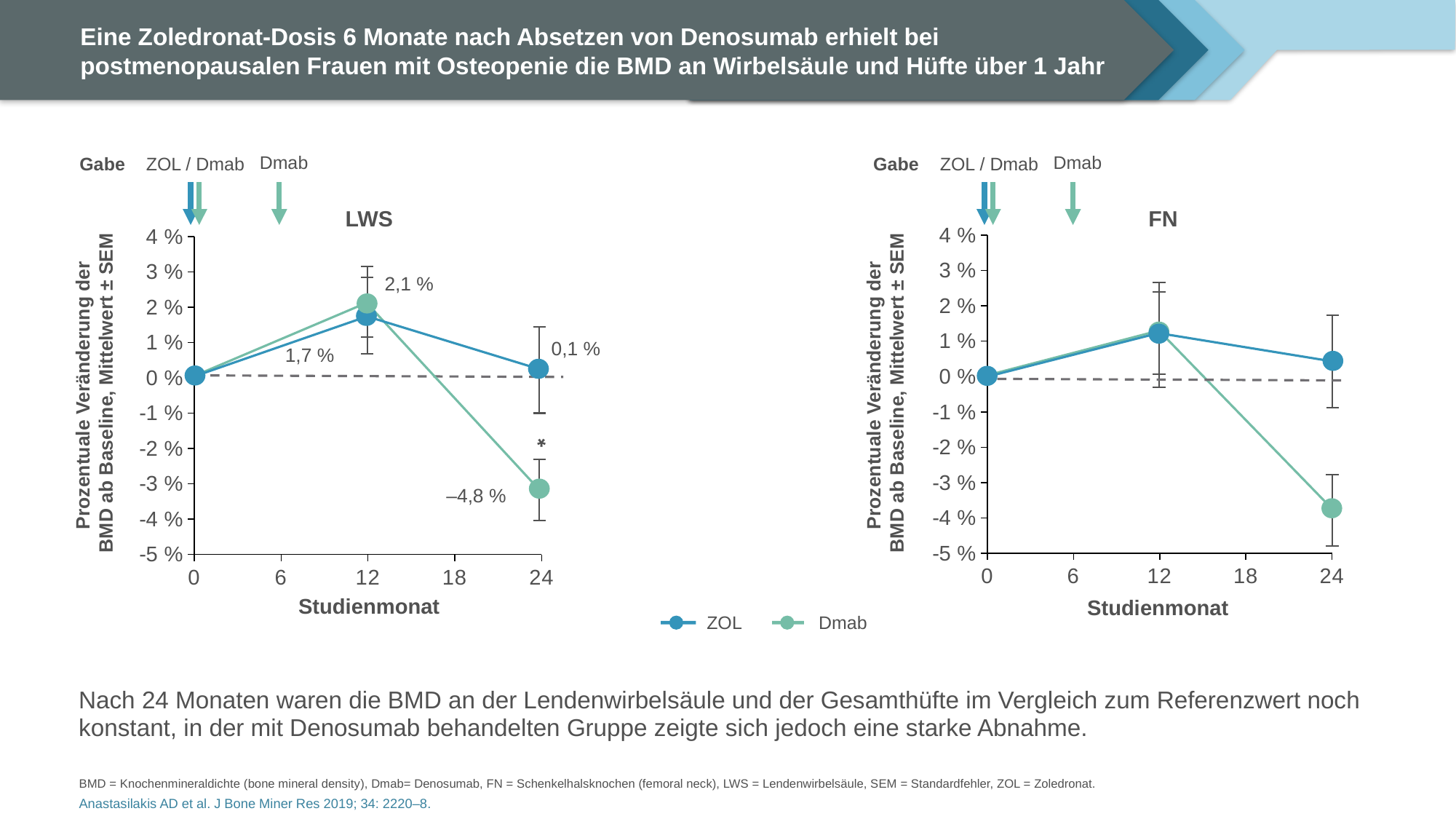
In the LWS chart, what is the value for Dmab at study month 12? 2,1 % How many series does the legend list? 2 In the LWS chart, what is the value for ZOL at study month 24? 0,1 % What is the title of the chart on the right side of the slide? FN In the LWS chart, what is the value for ZOL at study month 12? 1,7 % In the LWS chart, what is the value for Dmab at study month 24? –4,8 % In the FN chart, does the Dmab series rise or fall between study month 12 and study month 24? fall In the LWS chart, what is the difference between the Dmab and ZOL values at study month 12? 0,4 % In the LWS chart, which series has the higher value at study month 24, ZOL or Dmab? ZOL In the FN chart, is the value for ZOL at study month 24 greater or less than 0 %? greater What kind of chart is the FN chart? line chart In the FN chart, is the value for Dmab at study month 24 greater or less than -3 %? less